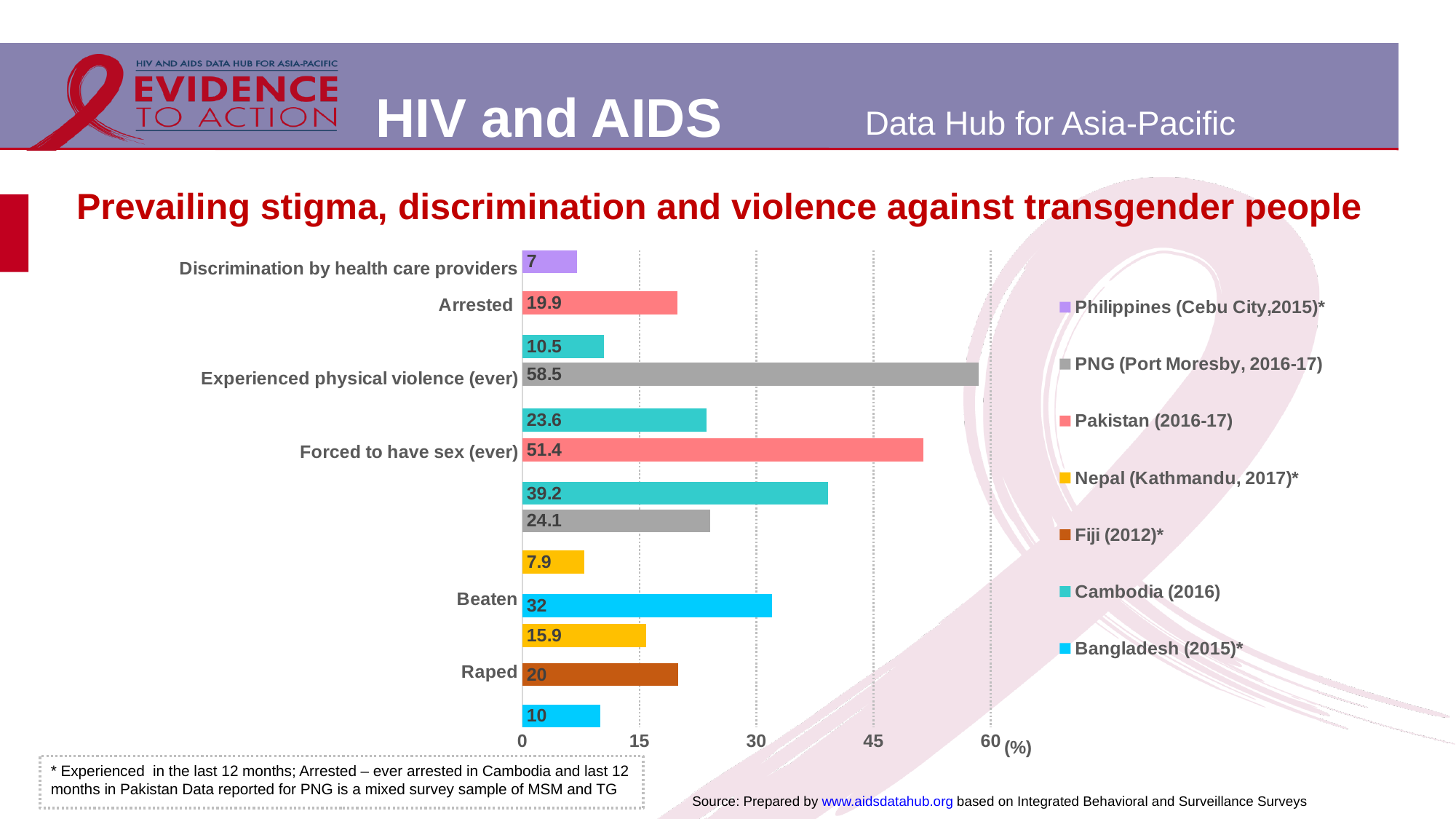
What is the value for Pakistan (2016-17) for Forced to have sex (ever)? 51.4 What is the value for Bangladesh (2015) for Beaten? 32 What is the value for PNG (Port Moresby, 2016-17) for Experienced physical violence (ever)? 58.5 What is the value for Philippines (Cebu City, 2015) for Discrimination by health care providers? 7 Which bar has the highest value on the chart? PNG (Port Moresby, 2016-17), Experienced physical violence (ever), 58.5 What kind of chart is shown on the slide? Bar chart What is the value for Pakistan (2016-17) for Arrested? 19.9 How many series does the legend list? 7 What is the value for Fiji (2012) for Raped? 20 Is the value for PNG (Port Moresby, 2016-17) for Experienced physical violence (ever) greater or less than 45? greater What is the lowest value shown on the chart? 7 What is the difference between PNG's value for Experienced physical violence (ever) and Pakistan's value for Forced to have sex (ever)? 7.1